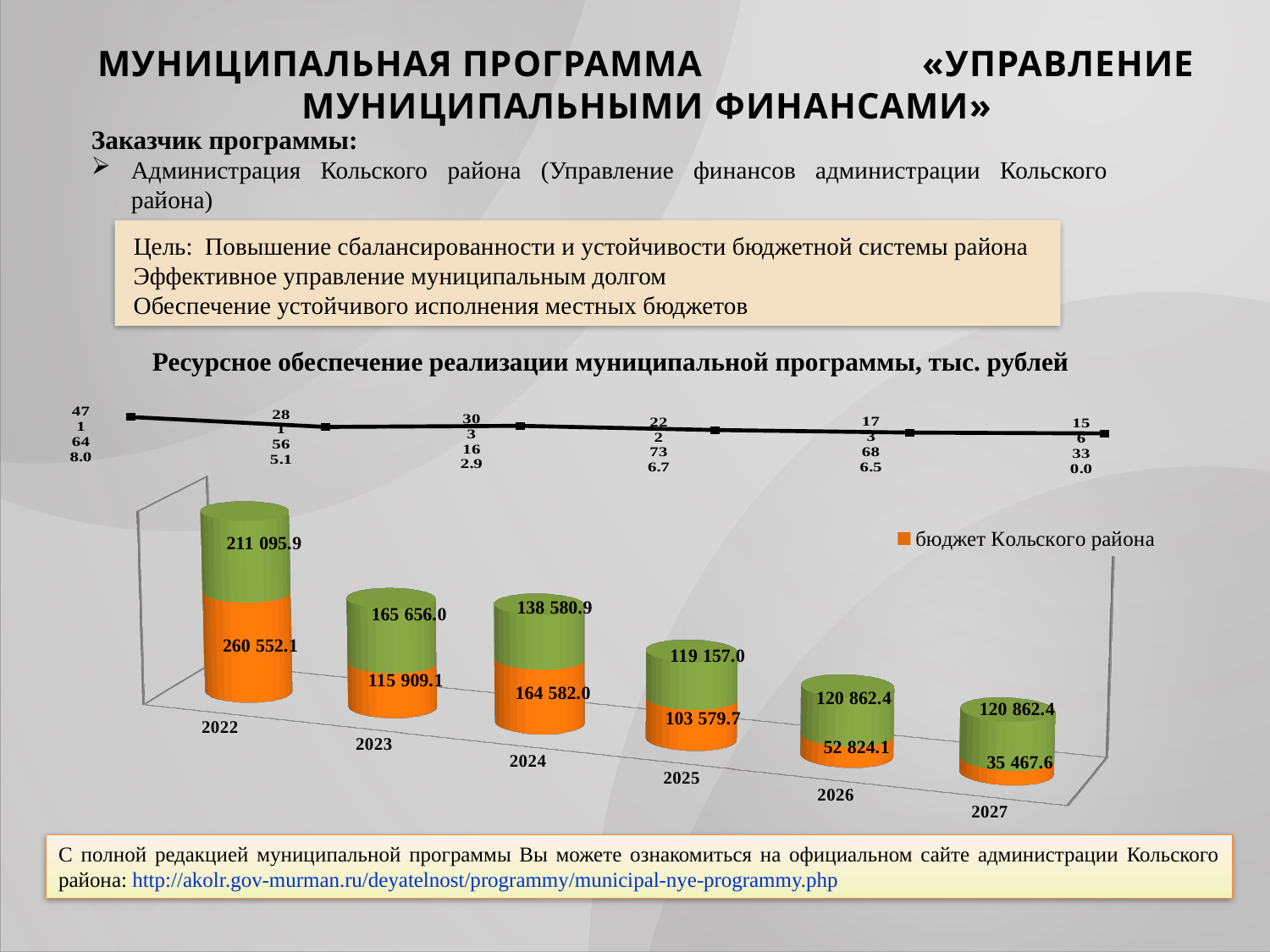
What is the difference between the 'бюджет Кольского района' values for 2022 and 2023? 144 643.0 What is the total of the stacked bar for 2026? 173 686.5 What is the value of the green (upper) segment for 2027? 120 862.4 What is the value of the 'бюджет Кольского района' series for 2022? 260 552.1 What is the title of the chart? Ресурсное обеспечение реализации муниципальной программы, тыс. рублей How many series does the chart legend list? 1 What is the value of the green (upper) segment for 2024? 138 580.9 What is the value of the 'бюджет Кольского района' series for 2026? 52 824.1 Which year has the lowest value for the 'бюджет Кольского района' series? 2027 Which is larger: the 'бюджет Кольского района' value for 2024 or for 2025? 2024 Which year has the highest value for the 'бюджет Кольского района' series? 2022 How many years are shown on the x axis of the chart? 6